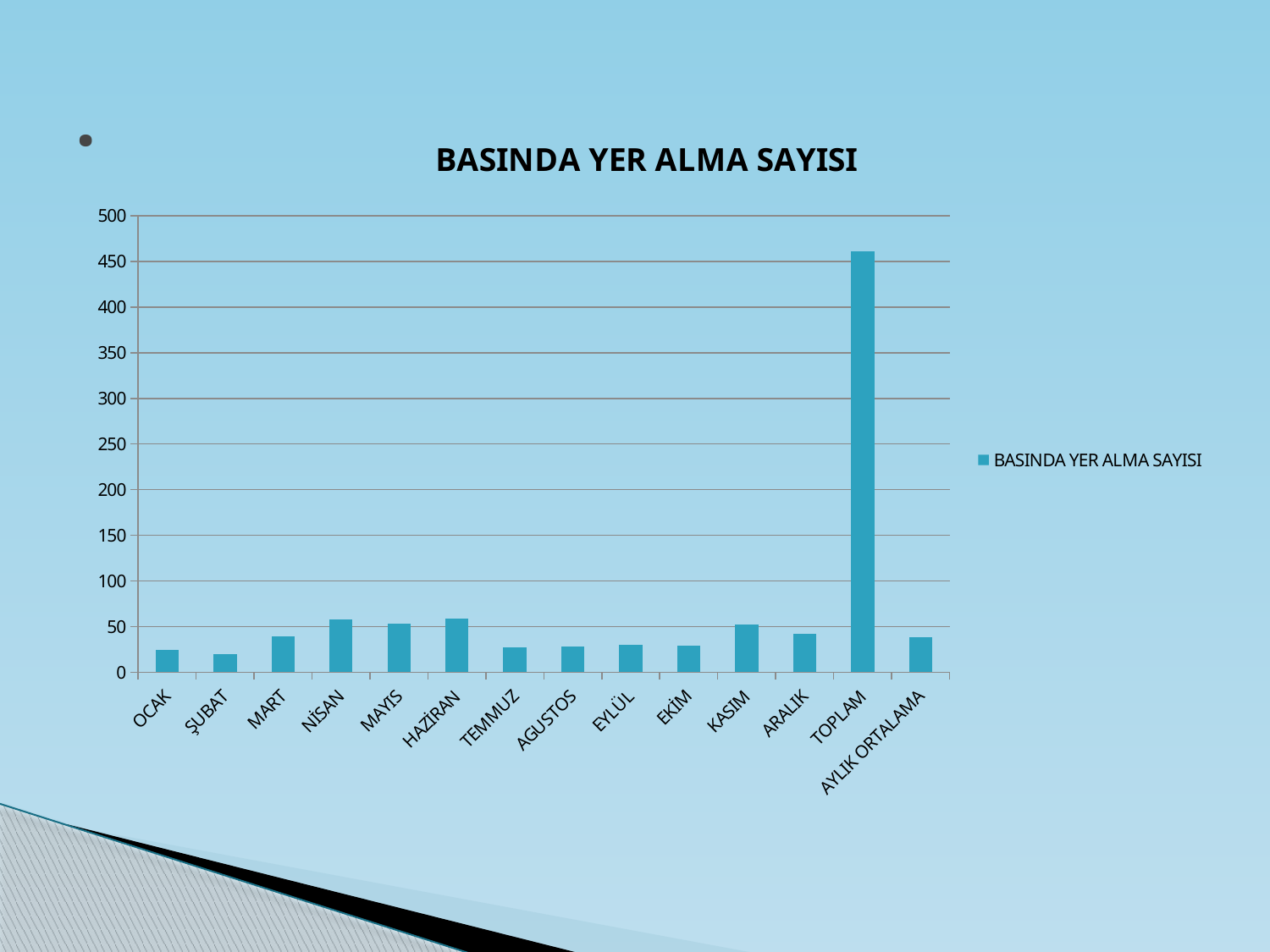
Is the value for NİSAN greater or less than 50? greater Is the value for TOPLAM greater or less than 400? greater Which category has the highest value? TOPLAM How many series does the legend list? 1 What is the legend entry shown on the chart? BASINDA YER ALMA SAYISI Is the value for TEMMUZ greater or less than 50? less What is the title of the chart? BASINDA YER ALMA SAYISI How many categories are shown on the x axis? 14 Which is larger, the value for NİSAN or the value for TEMMUZ? NİSAN Which is larger, the value for HAZİRAN or the value for ŞUBAT? HAZİRAN What kind of chart is shown on the slide? Bar chart